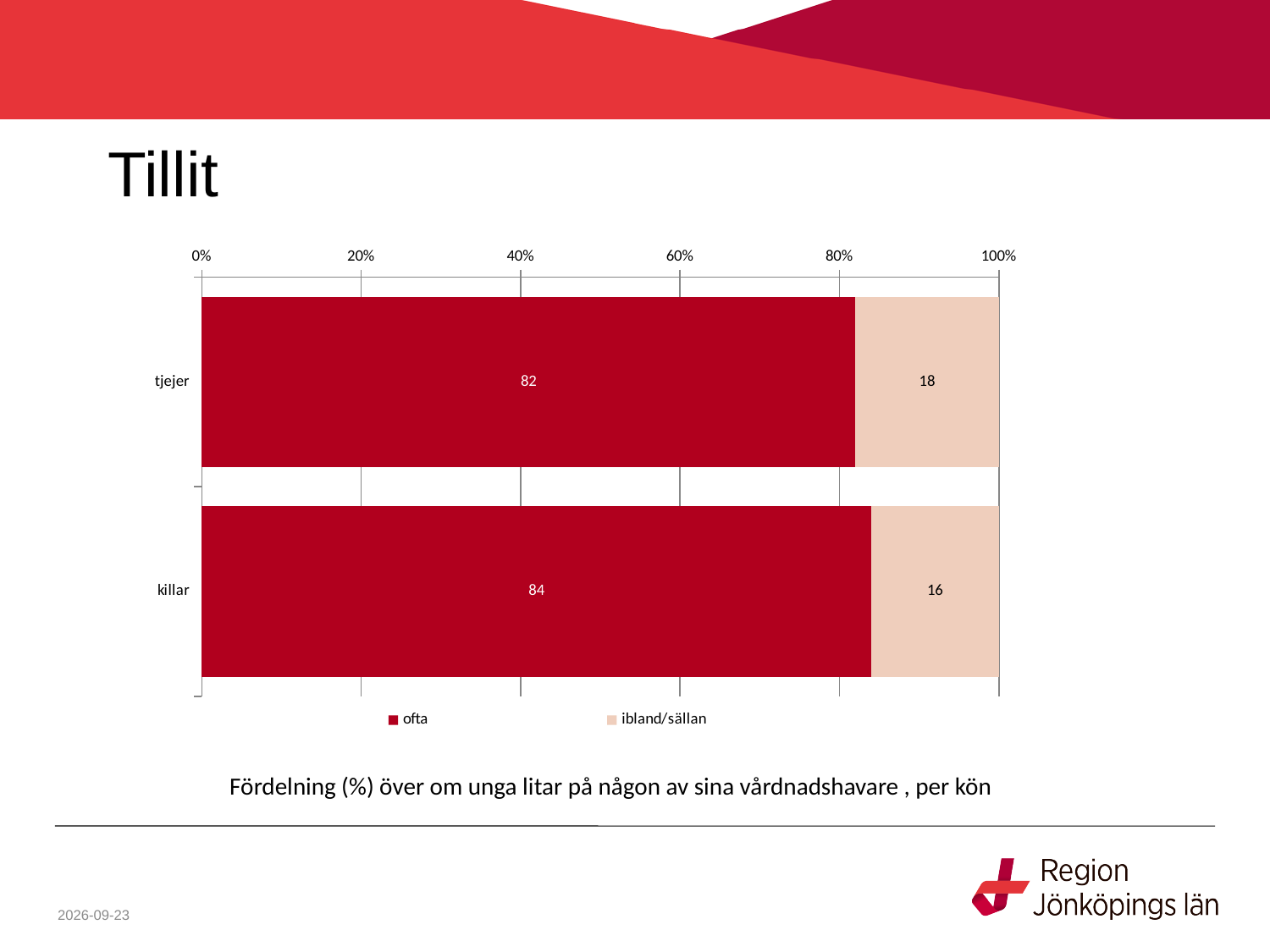
Which category has the higher value for "ofta"? killar What is the value for "ofta" for killar? 84 How many series does the legend list? 2 What is the total of the stacked bar for tjejer? 100 What is the value for "ofta" for tjejer? 82 What is the value for "ibland/sällan" for tjejer? 18 How many categories are shown on the chart? 2 Which category has the lower value for "ibland/sällan"? killar What is the difference between the "ofta" values for killar and tjejer? 2 What kind of chart is shown on the slide? Stacked bar chart What is the value for "ibland/sällan" for killar? 16 Is the "ofta" value for tjejer larger or smaller than the "ofta" value for killar? smaller